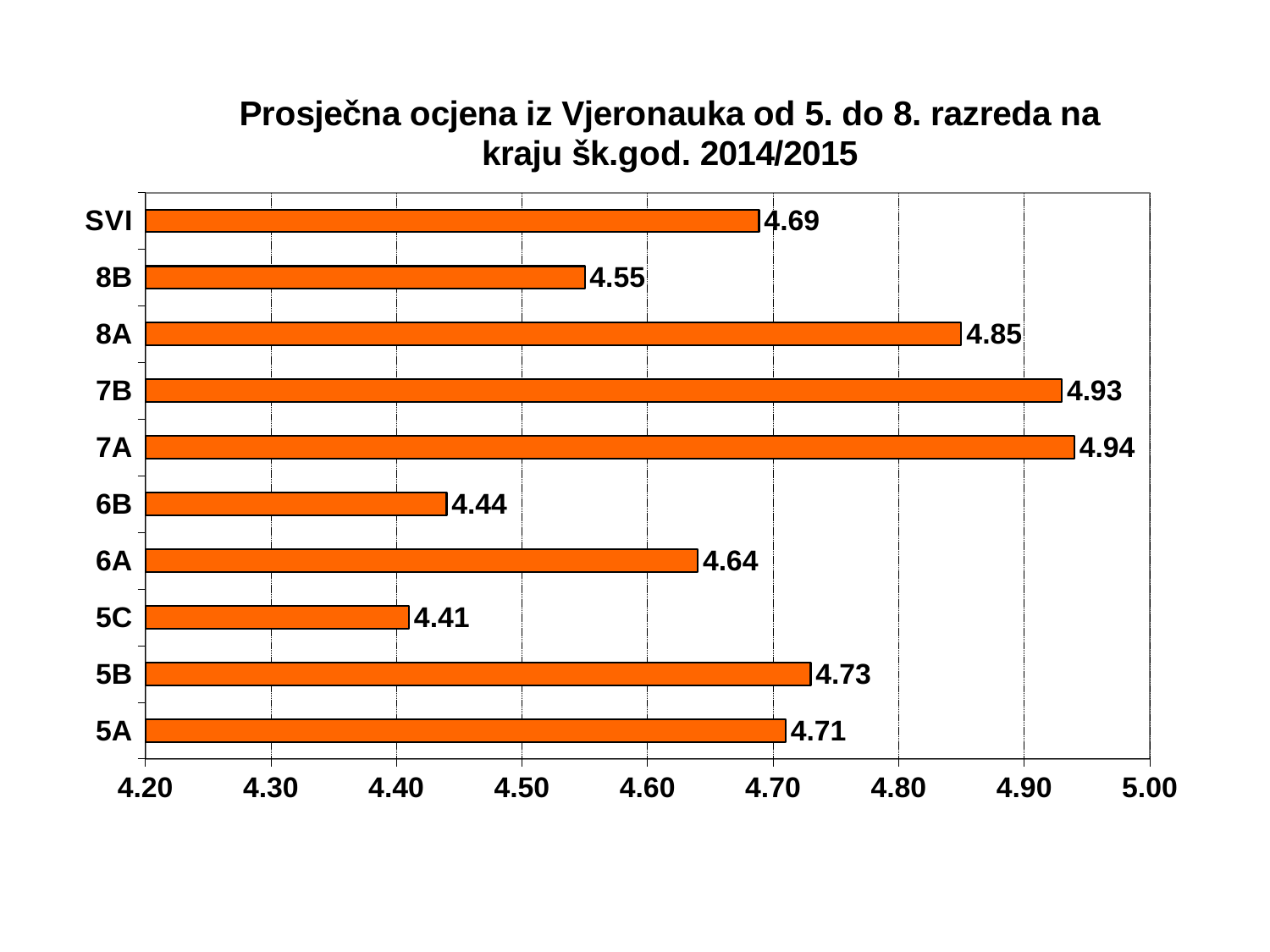
What is the title of the chart? Prosječna ocjena iz Vjeronauka od 5. do 8. razreda na kraju šk.god. 2014/2015 Is the value for 5B greater or less than 4.70? greater Which class has the highest average grade? 7A What is the difference between the values for 7A and 5C? 0.53 How many bars are shown in the chart? 10 What kind of chart is shown on the slide? Bar chart Which class has the lowest average grade? 5C Which has a higher average grade, 6A or 6B? 6A What is the value shown for SVI? 4.69 What is the average grade for class 5C? 4.41 What is the average grade for class 7B? 4.93 What is the difference between the values for 8A and 8B? 0.30